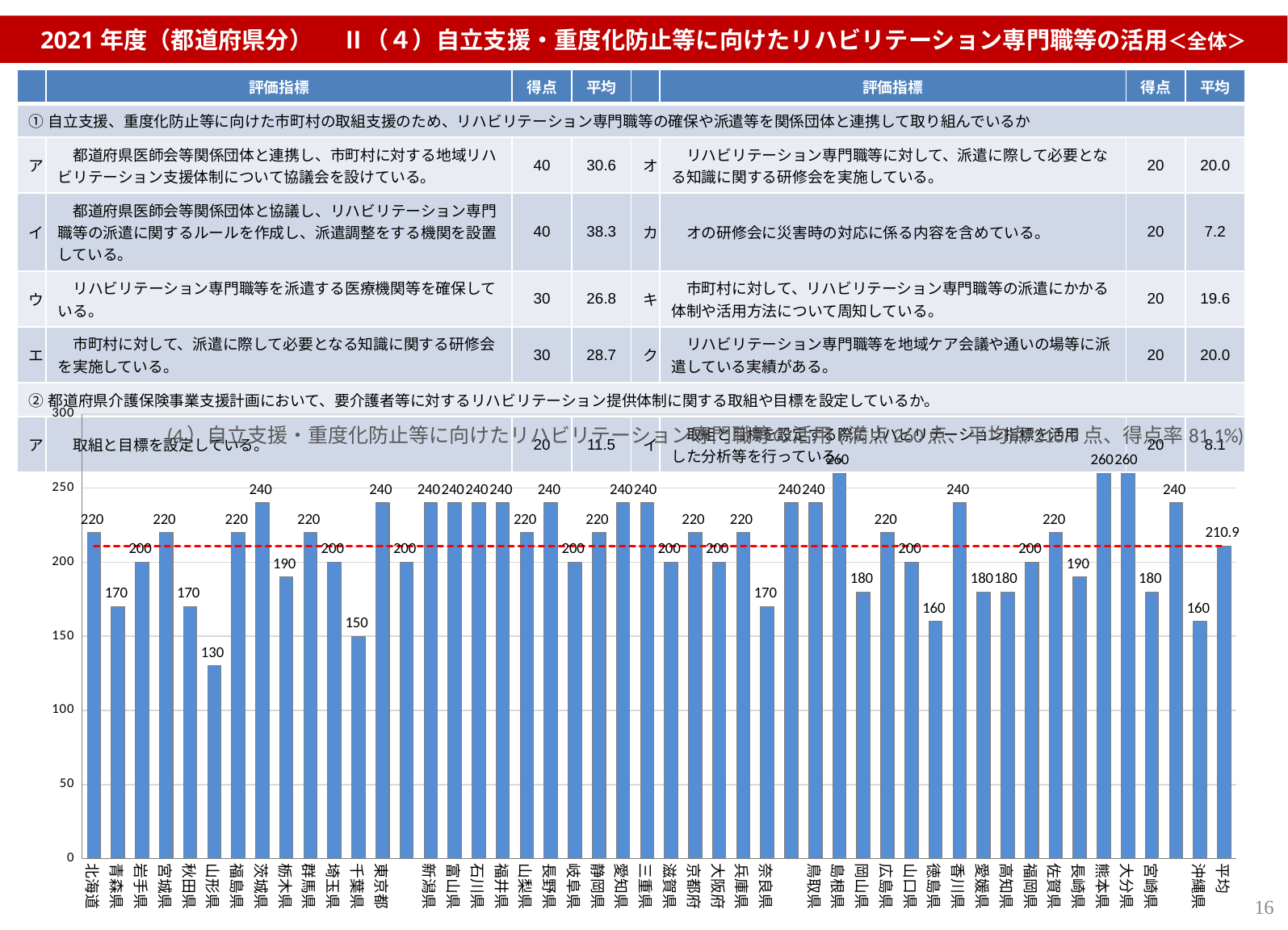
What is the difference between the values for 大分県 and 宮崎県? 80 What is the value for 熊本県 in the chart? 260 Which prefecture has the lowest value in the bar chart? 山形県 What is the value for 千葉県 in the chart? 150 Which has the larger value, 島根県 or 岡山県? 島根県 What is the value shown for 平均 (the last bar) in the chart? 210.9 What is the value for 山形県 in the bar chart? 130 Is the value for 沖縄県 greater or less than 200? less What colour is the horizontal dashed line drawn across the chart? red What is the highest value shown by any bar in the chart? 260 What is the difference between the values for 北海道 and 青森県? 50 What kind of chart is shown on the slide? bar chart